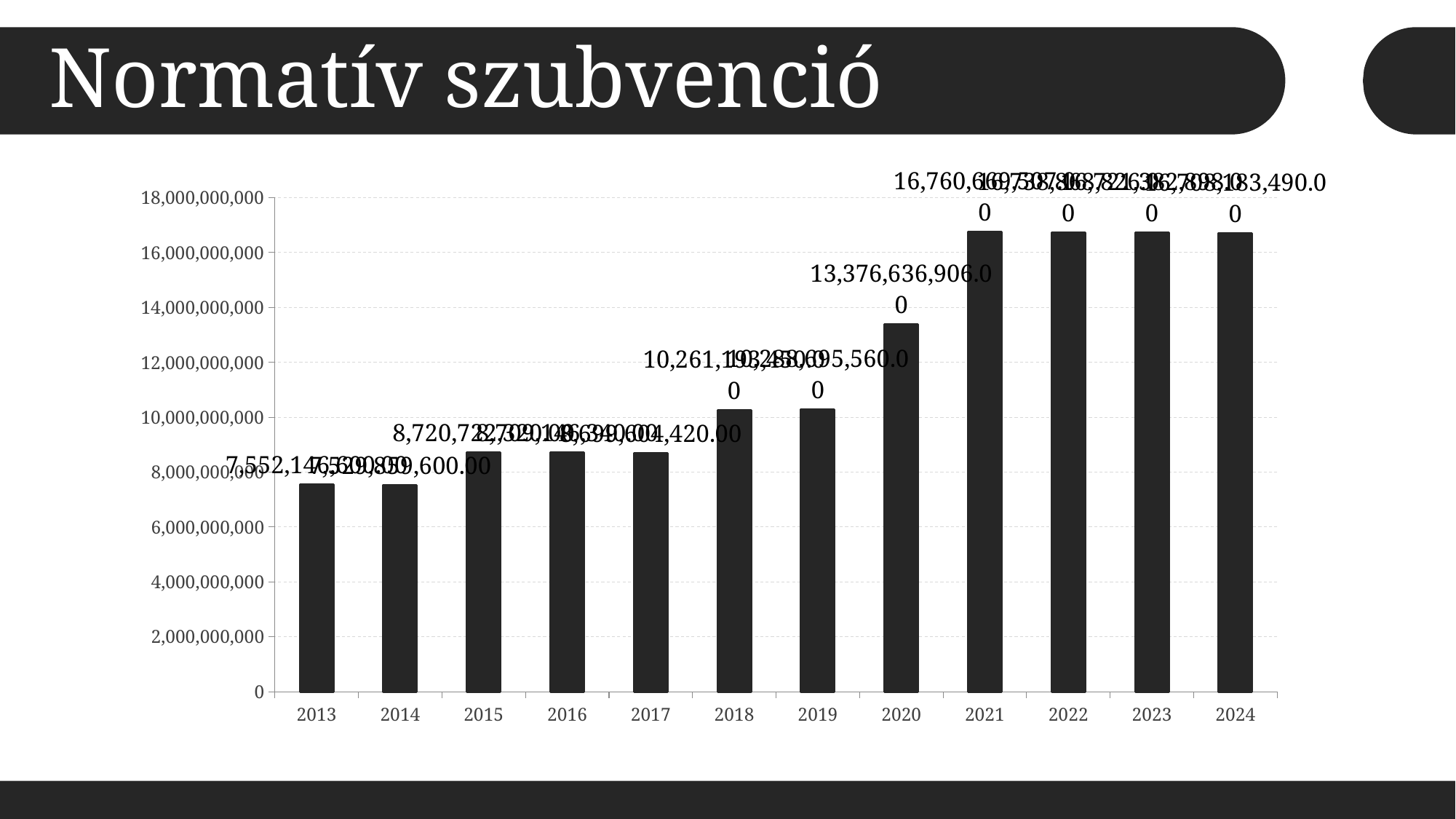
How many years are shown on the x axis of the chart? 12 Is the value for 2021 greater or less than 16,000,000,000? greater Is the value for 2015 greater or less than 8,000,000,000? greater Is the value for 2017 greater or less than 10,000,000,000? less Which is larger, the value for 2013 or the value for 2015? 2015 Do the values generally rise or fall from 2013 to 2024? rise What kind of chart is shown on the slide? bar chart What is the title of the slide containing the chart? Normatív szubvenció Which is larger, the value for 2018 or the value for 2020? 2020 What is the value for 2020? 13,376,636,906.00